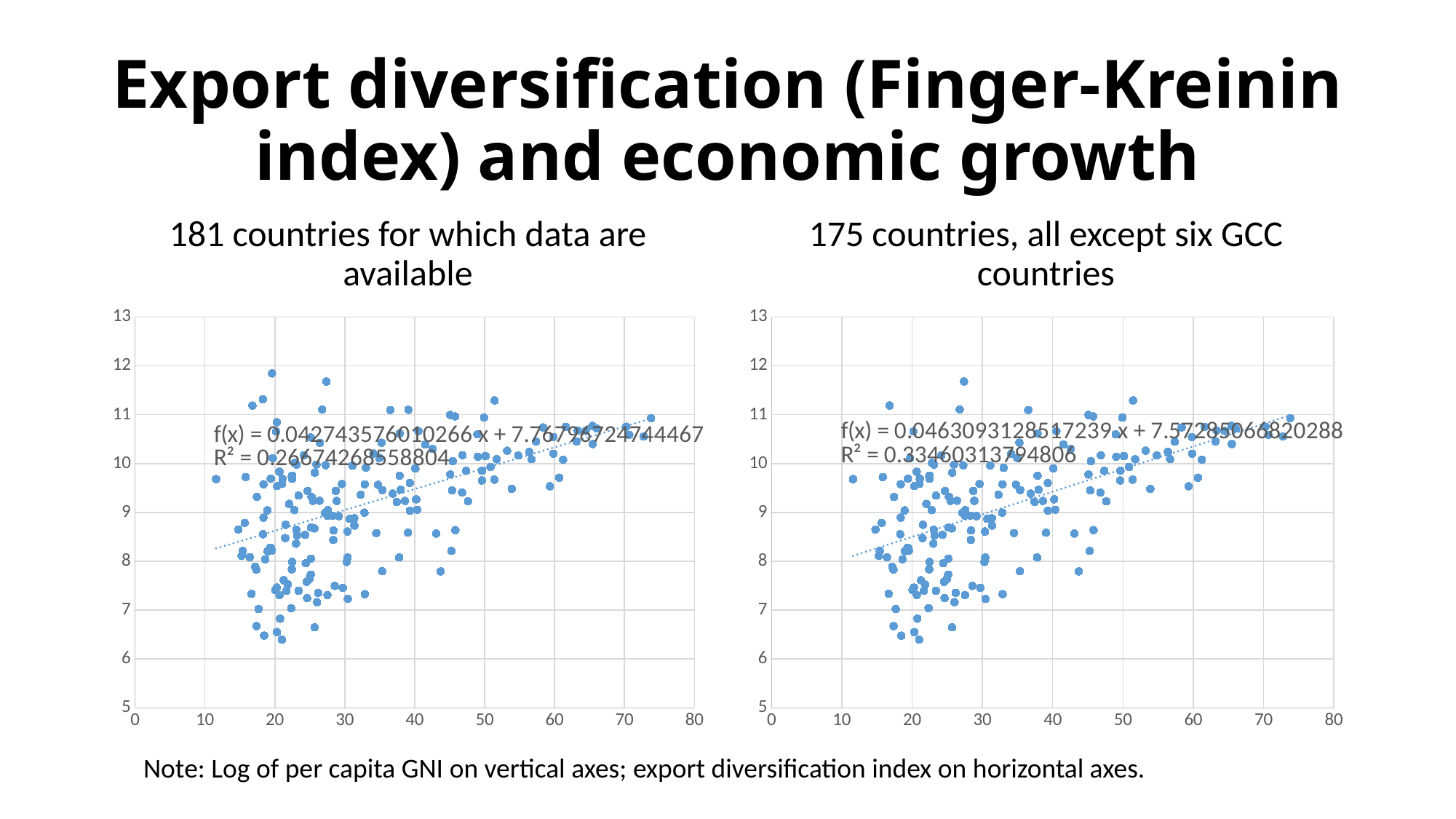
On the left chart (181 countries), is the highest plotted point greater or less than 11 on the vertical axis? greater Which chart has the higher R² value, the left chart (181 countries) or the right chart (175 countries)? The right chart (175 countries) On the right chart (175 countries), what is the intercept in the trendline equation f(x)? 7.57285066820288 On the left chart (181 countries), what is the R² value shown for the trendline? R² = 0.26674268558804 How many countries (data points) does the right chart's title say are plotted? 175 How many countries (data points) does the left chart's title say are plotted? 181 On the left chart (181 countries), what is the slope coefficient in the trendline equation f(x)? 0.042743576010266 On the right chart (175 countries, all except six GCC countries), what is the R² value shown for the trendline? R² = 0.33460313794806 On the right chart (175 countries), is the lowest plotted point greater or less than 7 on the vertical axis? less What is the maximum value shown on the vertical axis of the left chart (181 countries)? 13 What kind of chart is the left chart titled '181 countries for which data are available'? Scatter chart On the right chart (175 countries), do the plotted values generally rise or fall as the export diversification index increases along the x axis? Rise